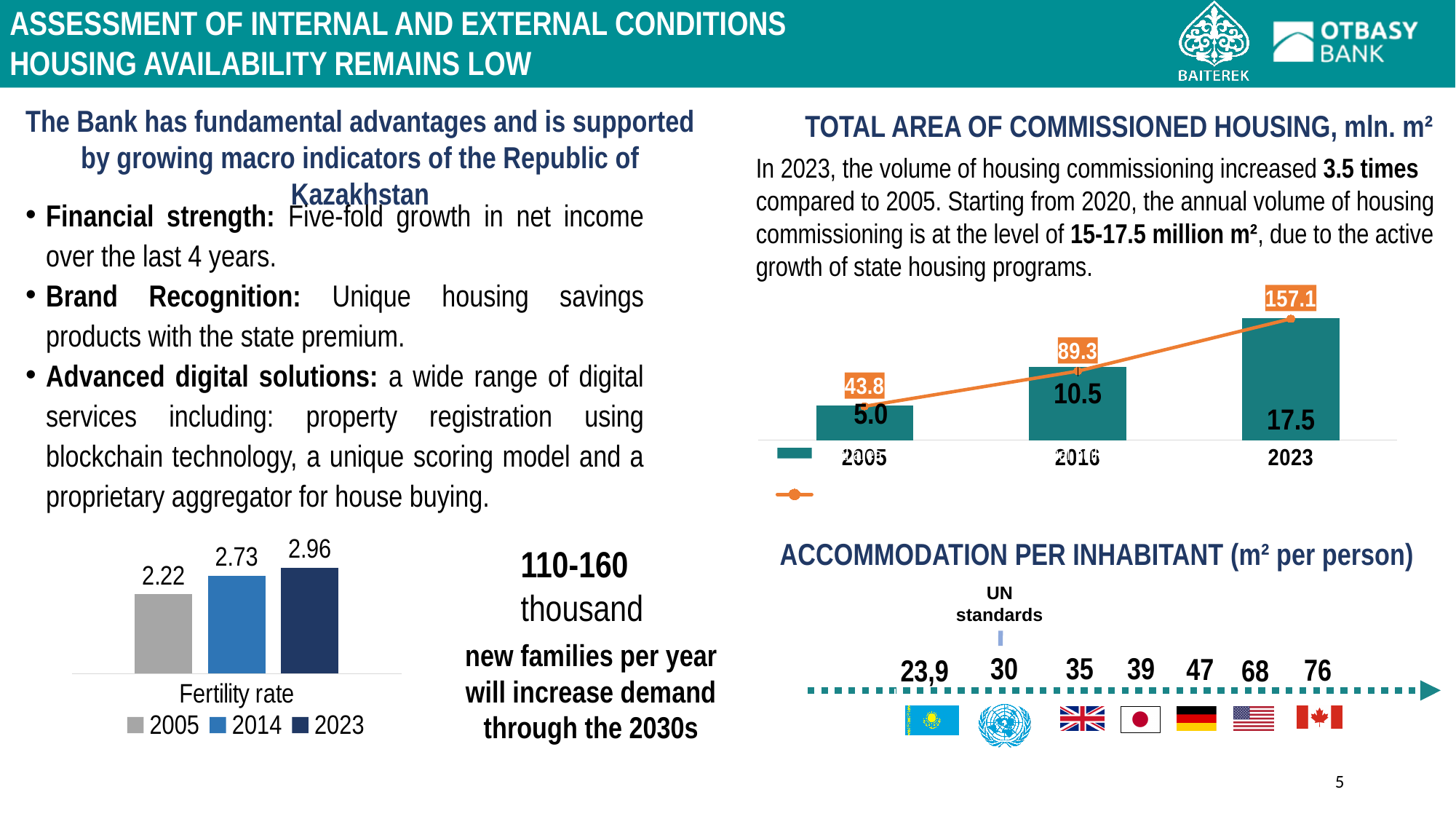
In the 'Total area of commissioned housing' chart, what is the bar value for 2023? 17.5 In the 'Total area of commissioned housing' chart, do the bar values rise or fall from 2005 to 2023? rise In the 'Fertility rate' chart, what is the value for 2023? 2.96 In the 'Total area of commissioned housing' chart, what is the bar value for 2005? 5.0 In the 'Total area of commissioned housing' chart, which year has the highest bar? 2023 In the 'Fertility rate' chart, how many series does the legend list? 3 In the 'Total area of commissioned housing' chart, how many years are shown on the x axis? 3 In the 'Total area of commissioned housing' chart, what is the difference between the 2023 and 2005 bar values? 12.5 In the 'Fertility rate' chart, what is the value for 2005? 2.22 In the 'Fertility rate' chart, which year has the lowest value? 2005 In the 'Total area of commissioned housing' chart, what is the line value labelled above the 2005 bar? 43.8 In the 'Total area of commissioned housing' chart, what is the line value labelled above the 2023 bar? 157.1